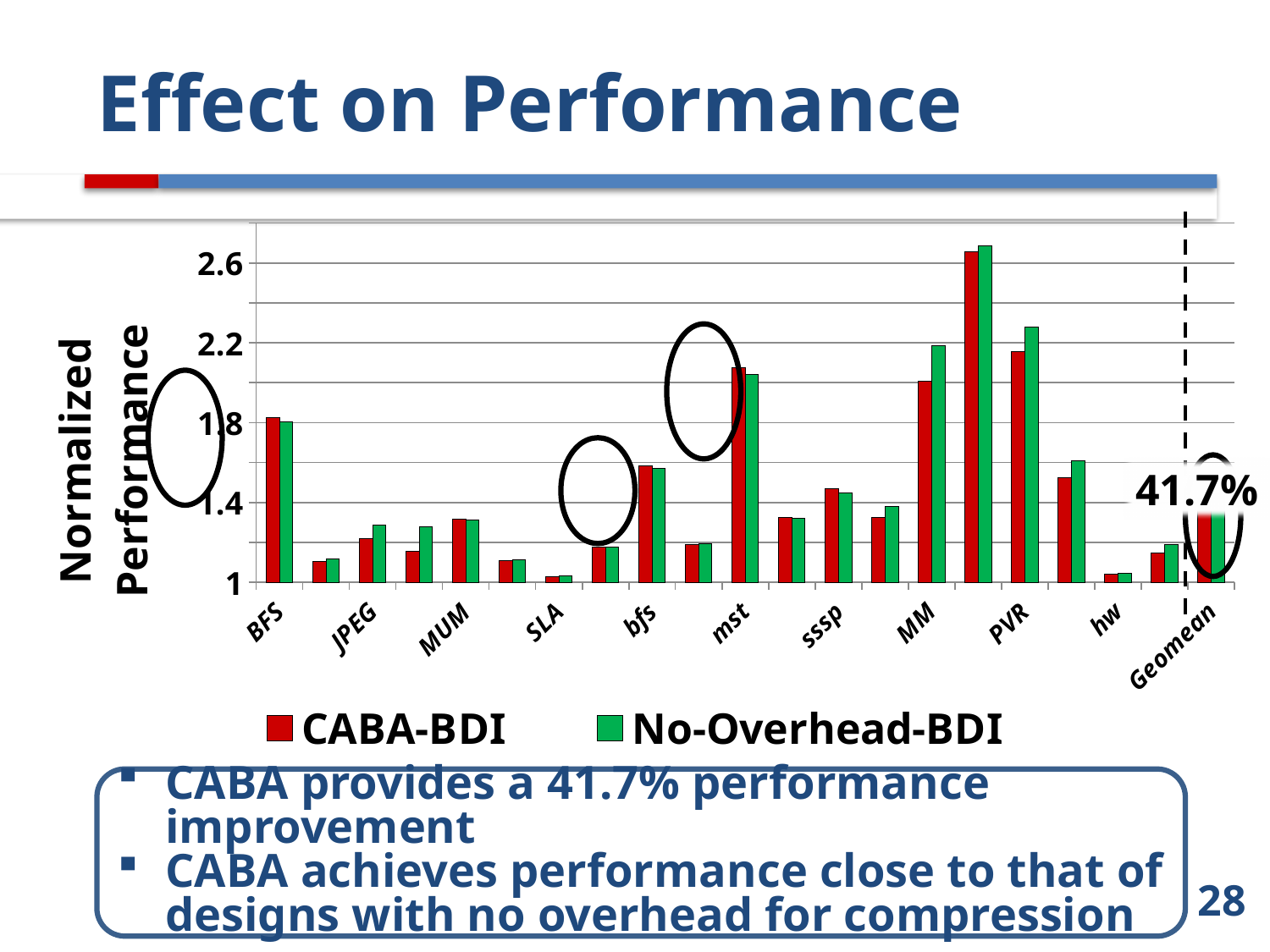
What percentage is annotated next to the Geomean bars? 41.7% Is the CABA-BDI value for BFS greater or less than 2.2? less Is the CABA-BDI value for Geomean greater or less than 1.8? less Is the CABA-BDI value for BFS greater or less than 1.4? greater What are the two series named in the legend? CABA-BDI and No-Overhead-BDI How many series does the legend list? 2 What kind of chart is shown on the slide? bar chart